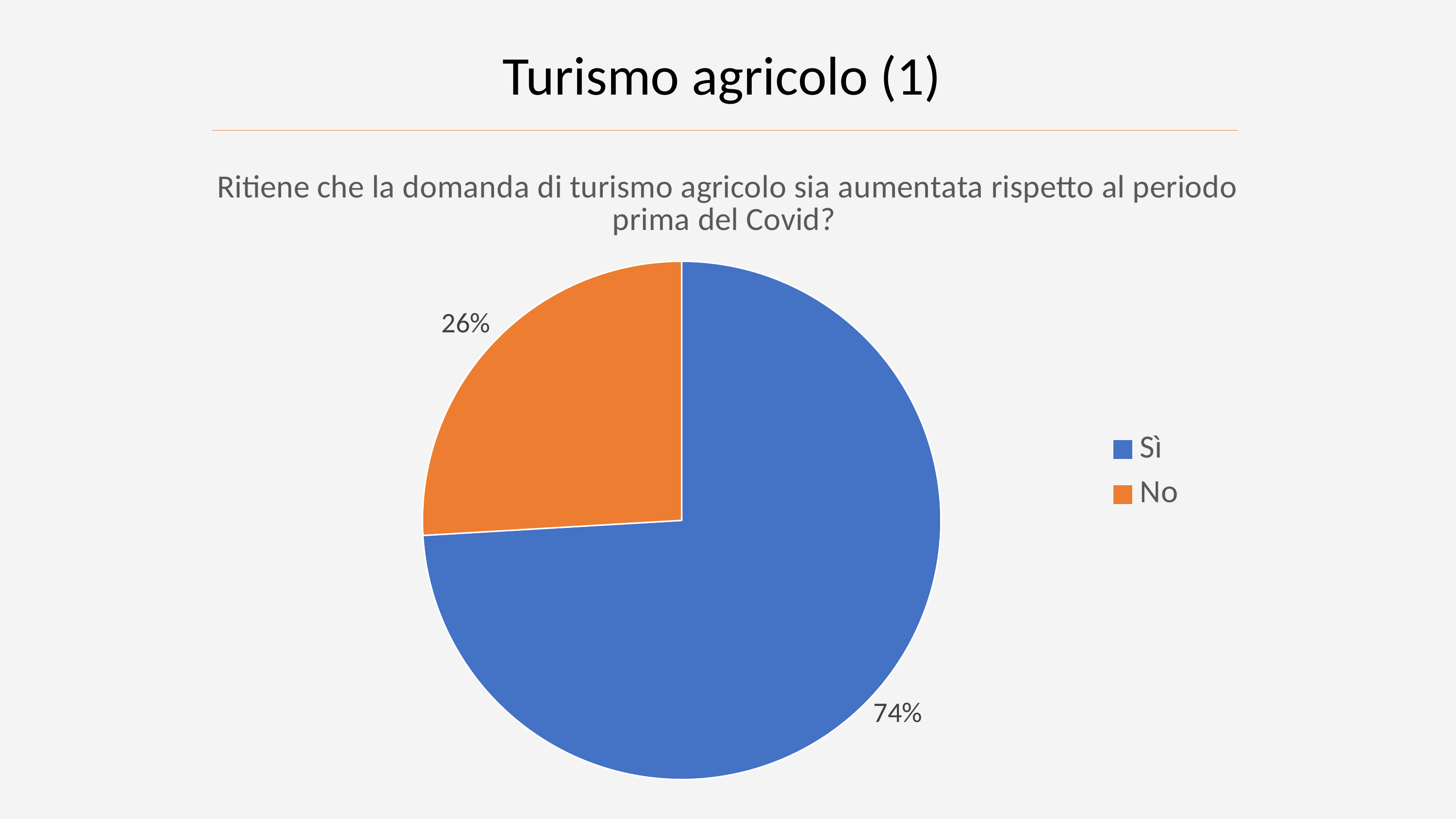
What kind of chart is shown on the slide? Pie chart How many entries does the legend list? 2 What is the title of the chart? Ritiene che la domanda di turismo agricolo sia aumentata rispetto al periodo prima del Covid? What is the difference in percentage points between the Sì and No slices? 48 What colour is the No slice? Orange What percentage of respondents answered Sì? 74% What share of the pie does the Sì slice represent? 74% Which response has the largest share of the pie? Sì What percentage of respondents answered No? 26% Which response has the smallest share of the pie? No Which slice is larger, Sì or No? Sì How many slices does the pie chart have? 2